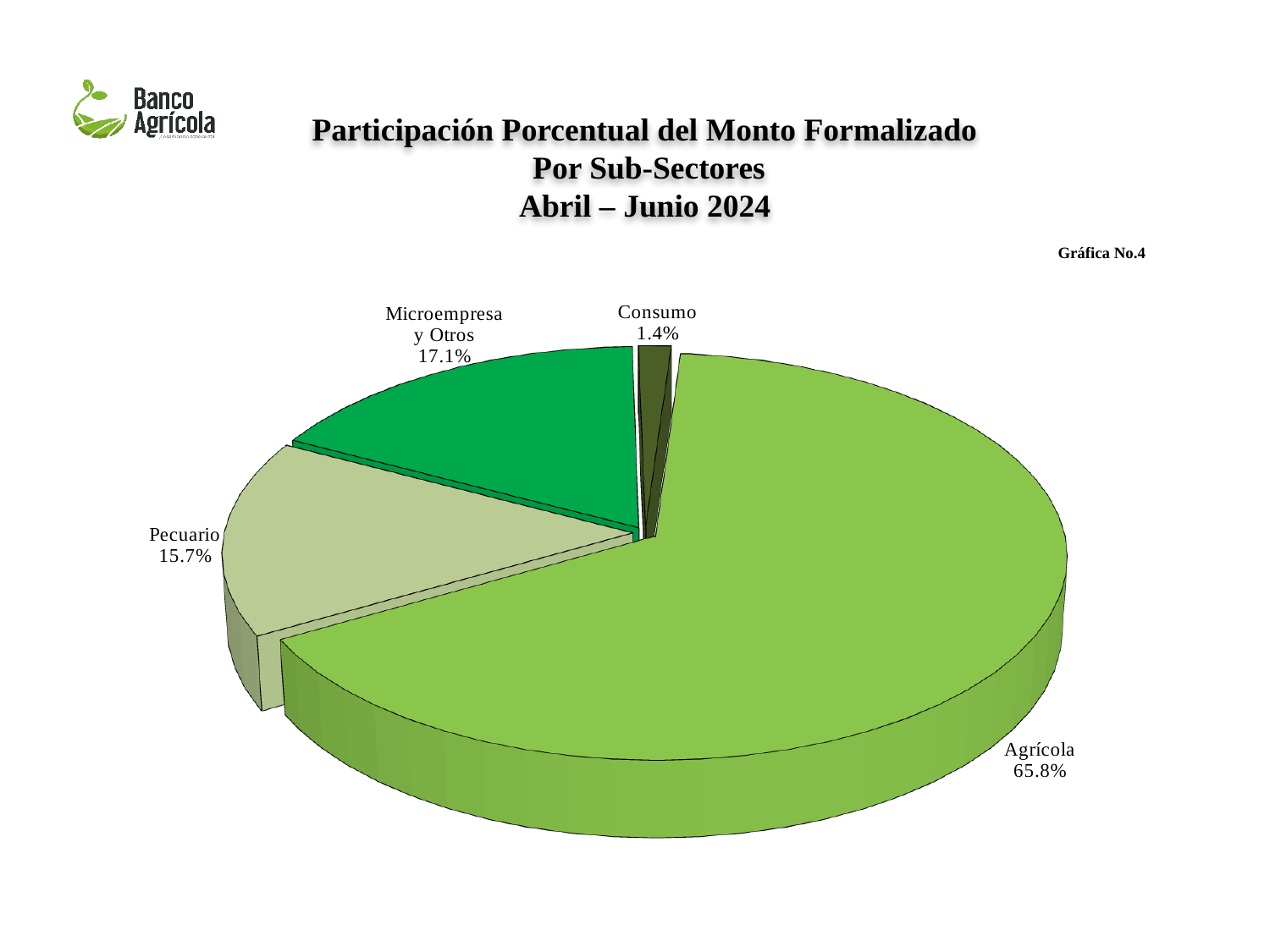
What is the share for Agrícola? 65.8% What is the difference in percentage points between Agrícola and Microempresa y Otros? 48.7 Which has a larger share, Pecuario or Microempresa y Otros? Microempresa y Otros Which sub-sector has the smallest share? Consumo Which sub-sector has the largest share? Agrícola How many slices does the pie chart have? 4 What type of chart is shown on the slide? Pie chart What is the difference in percentage points between Microempresa y Otros and Pecuario? 1.4 What is the share for Microempresa y Otros? 17.1% What is the share for Pecuario? 15.7% What is the share for Consumo? 1.4% What is the title of the chart? Participación Porcentual del Monto Formalizado Por Sub-Sectores Abril – Junio 2024